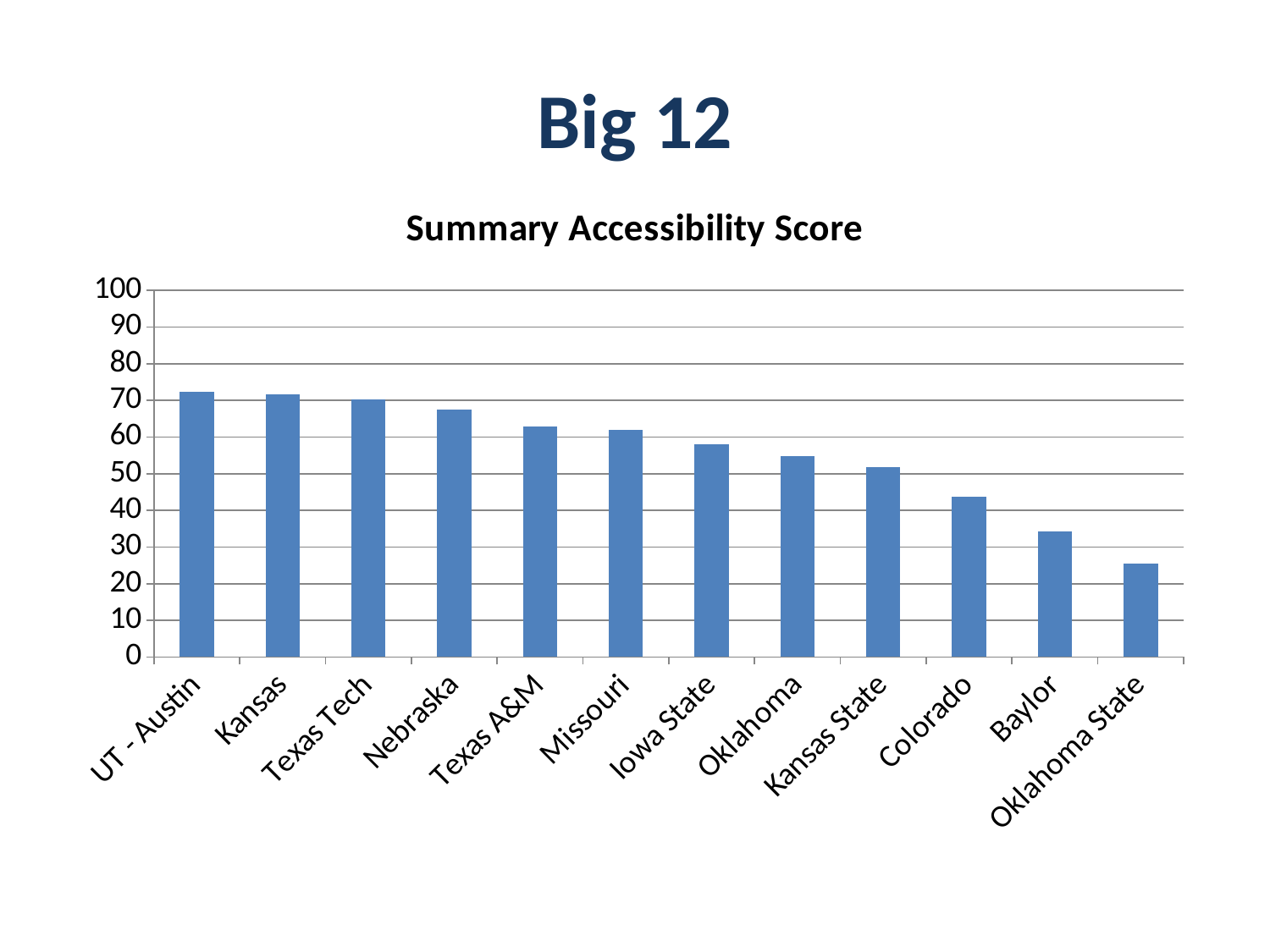
Is the value for Nebraska greater or less than 60? greater Which university has the lowest Summary Accessibility Score? Oklahoma State Is the value for Oklahoma greater or less than 60? less What is the title of the chart? Summary Accessibility Score Is the value for Baylor greater or less than 30? greater How many universities are shown on the x axis of the chart? 12 Do the values rise or fall moving from left to right along the x axis? Fall Which has the larger value, Nebraska or Colorado? Nebraska Which has the larger value, Baylor or Oklahoma State? Baylor What kind of chart is shown on the slide? Bar chart